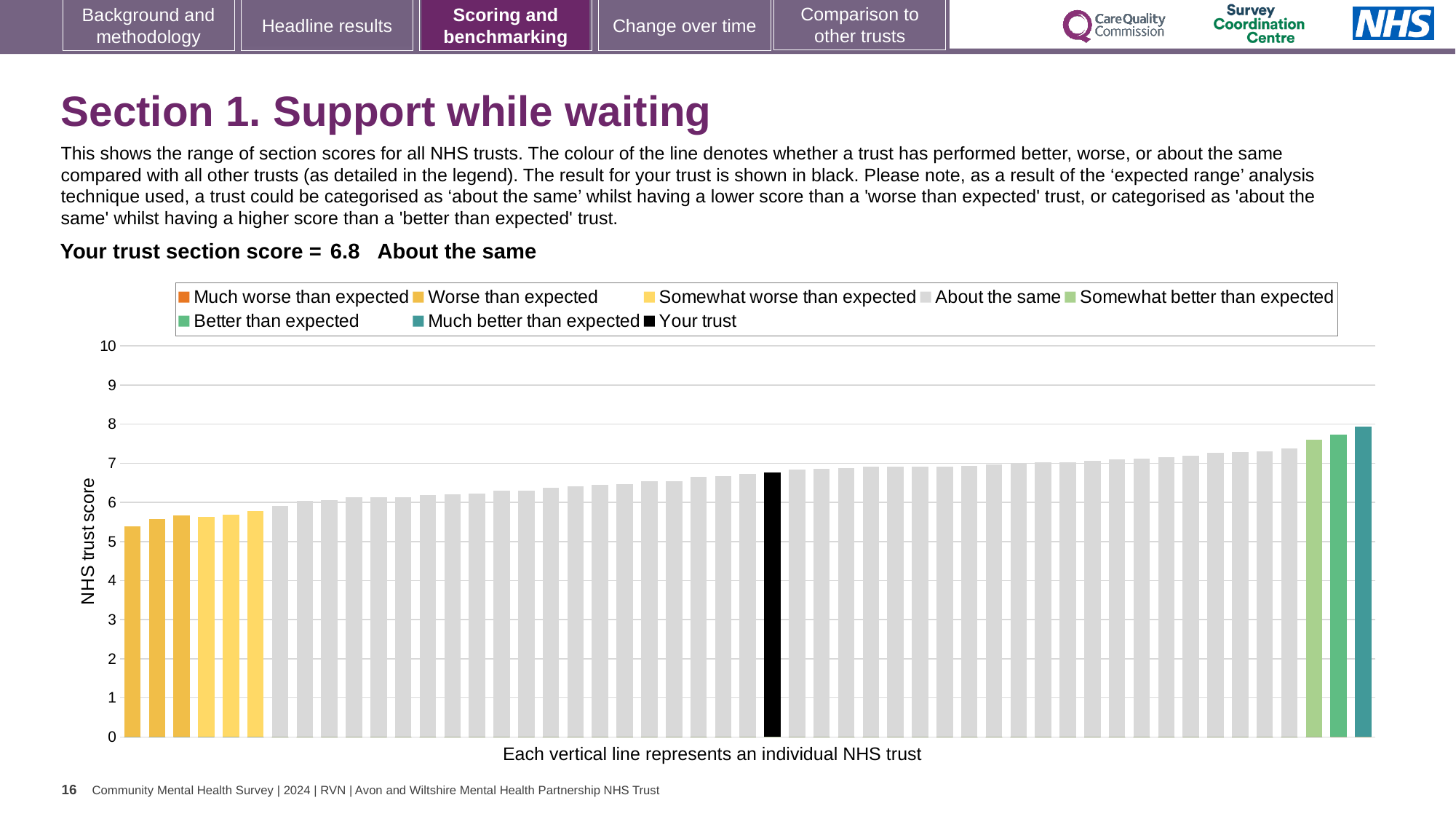
What kind of chart is shown on the slide? Bar chart Is the value of the shortest bar greater or less than 5? greater Do the bar values rise or fall from left to right along the x axis? rise What is the title of the vertical axis? NHS trust score How many entries does the chart legend list? 8 Which legend category does the tallest bar belong to? Much better than expected Is the value of the black 'Your trust' bar greater or less than 6? greater Is the value of the black 'Your trust' bar greater or less than 7? less Which legend category is the trust's section score classified as? About the same Which is larger, the leftmost bar or the rightmost bar? the rightmost bar What is the trust section score shown on the slide? 6.8